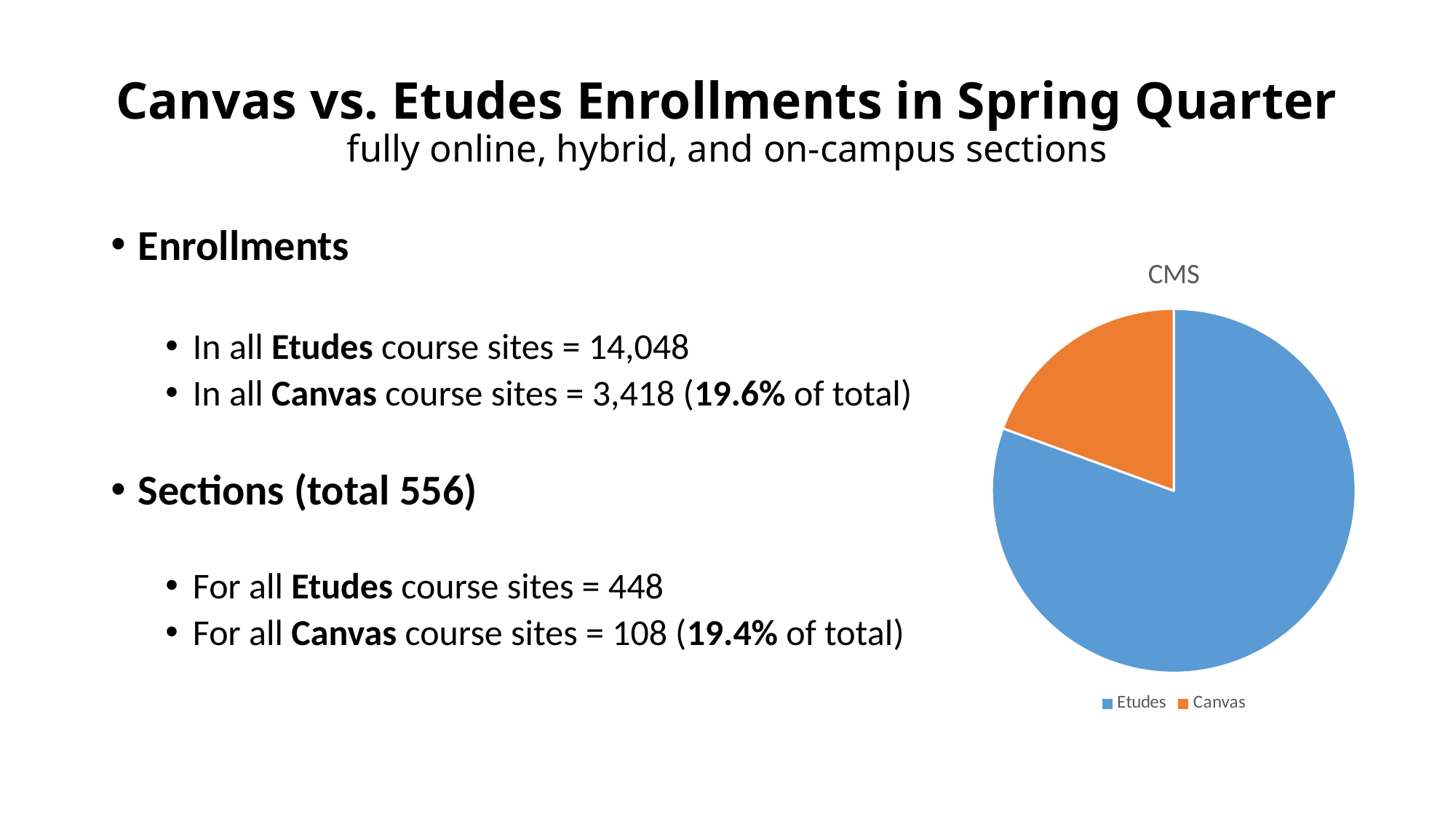
Does the Canvas slice of the pie chart take up more or less than half of the pie? less Which slice of the pie chart is the largest? Etudes What is the title of the pie chart? CMS In the pie chart, which is larger, the Etudes slice or the Canvas slice? Etudes What colour is the Canvas slice in the pie chart? orange Which slice of the pie chart is the smallest? Canvas What kind of chart is shown on the slide? pie chart How many slices does the pie chart have? 2 How many entries does the pie chart's legend list? 2